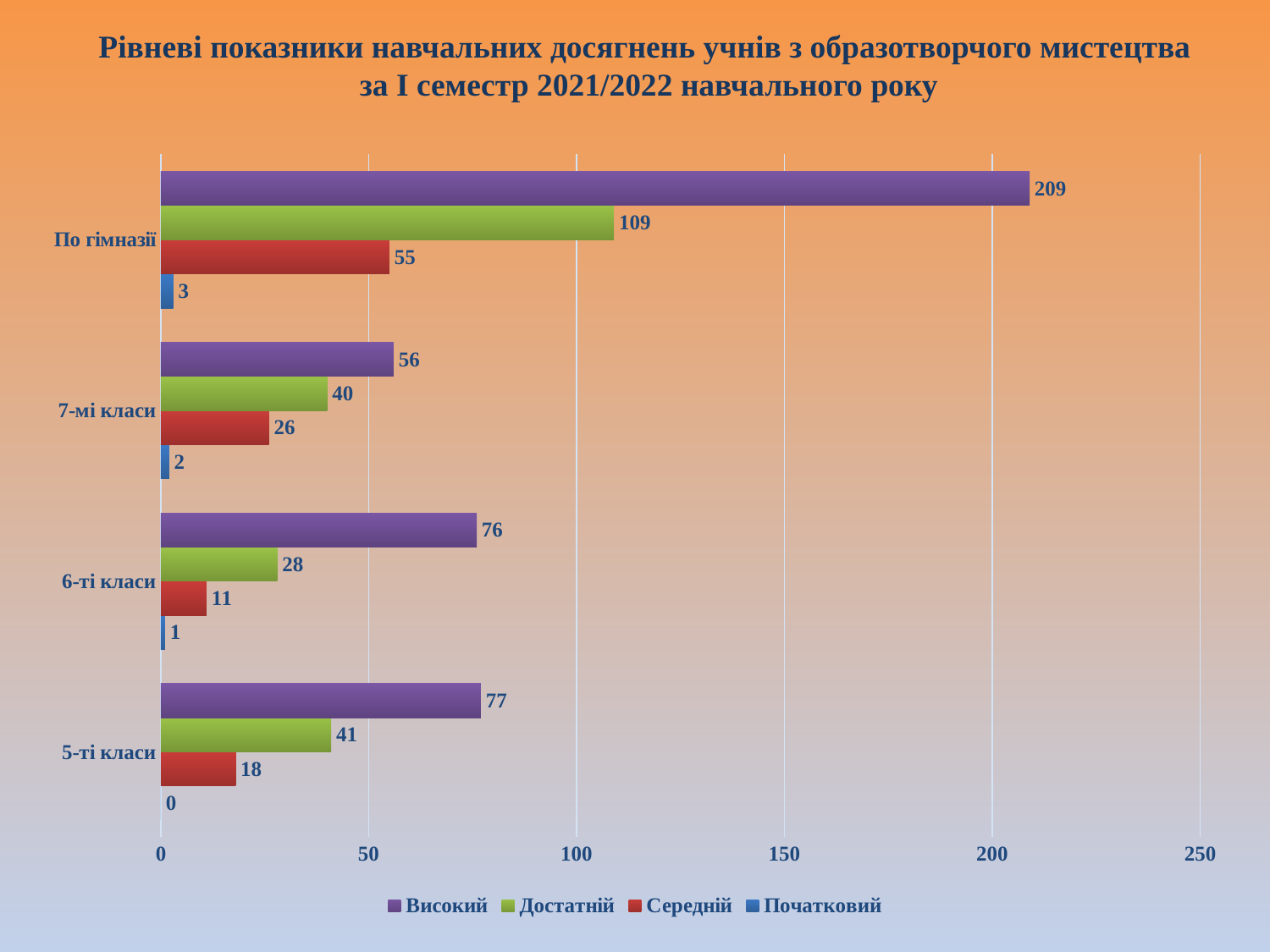
Which category has the lowest Середній value? 6-ті класи Which category has the highest Високий value? По гімназії What is the value of Початковий for 5-ті класи? 0 What is the value of Достатній for 7-мі класи? 40 What is the difference between the Достатній values for По гімназії and 7-мі класи? 69 Which is larger: Високий for 6-ті класи or Високий for 7-мі класи? 6-ті класи What is the value of Високий for По гімназії? 209 How many series does the legend list? 4 What is the value of Середній for 6-ті класи? 11 How many categories are shown on the y axis? 4 What kind of chart is shown on the slide? bar chart Which series is shown in green in the legend? Достатній